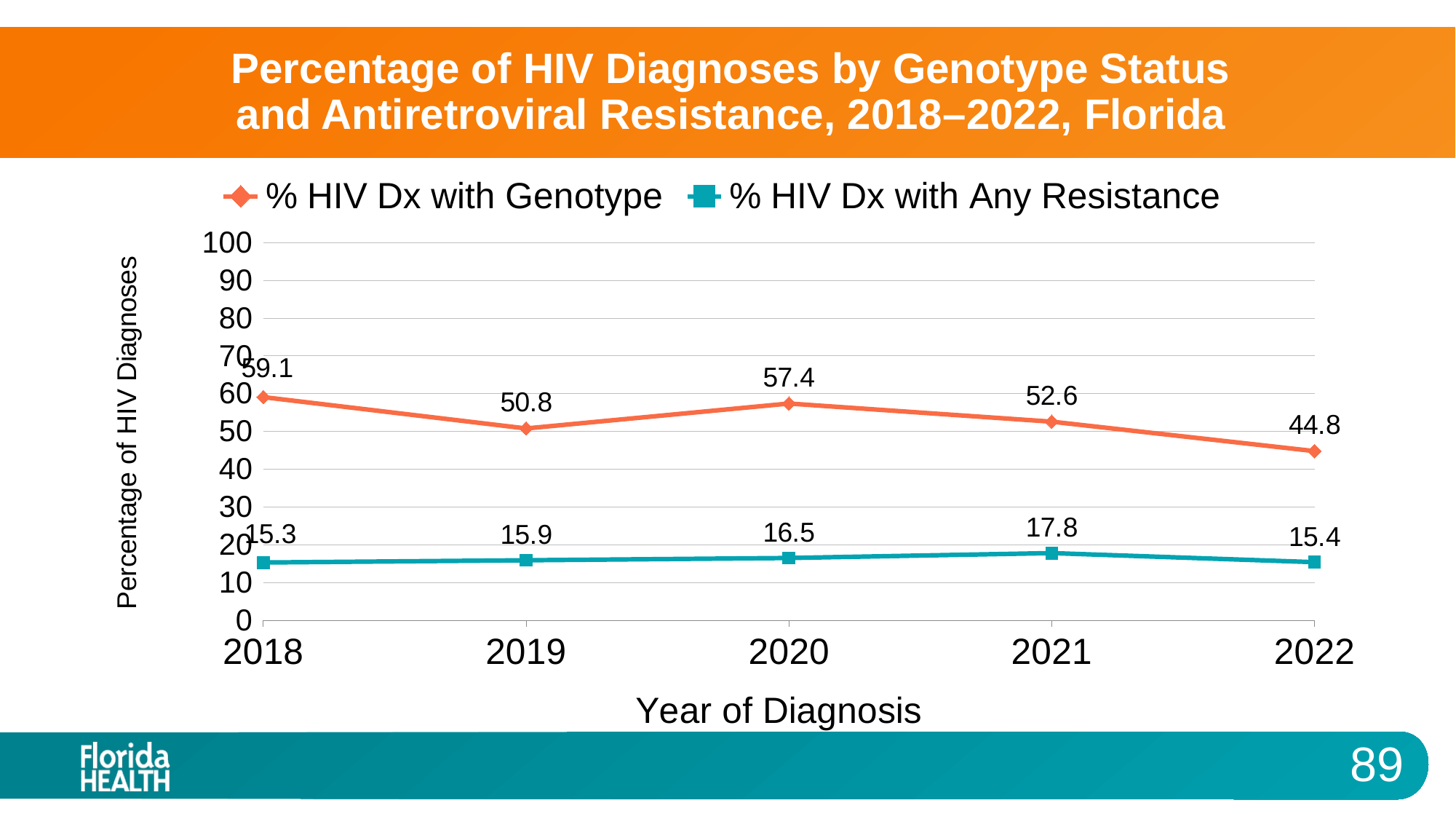
Which is larger: % HIV Dx with Genotype in 2019 or in 2020? 2020 In which year is % HIV Dx with Any Resistance lowest? 2018 Is the value for % HIV Dx with Genotype in 2021 greater or less than 50? greater How many series does the legend list? 2 What is the value for % HIV Dx with Genotype in 2022? 44.8 How many years are plotted on the x axis? 5 In which year is % HIV Dx with Genotype highest? 2018 What is the difference between % HIV Dx with Genotype in 2018 and in 2022? 14.3 What is the value for % HIV Dx with Genotype in 2018? 59.1 What is the value for % HIV Dx with Any Resistance in 2021? 17.8 What is the label of the y axis? Percentage of HIV Diagnoses What kind of chart is shown on the slide? Line chart